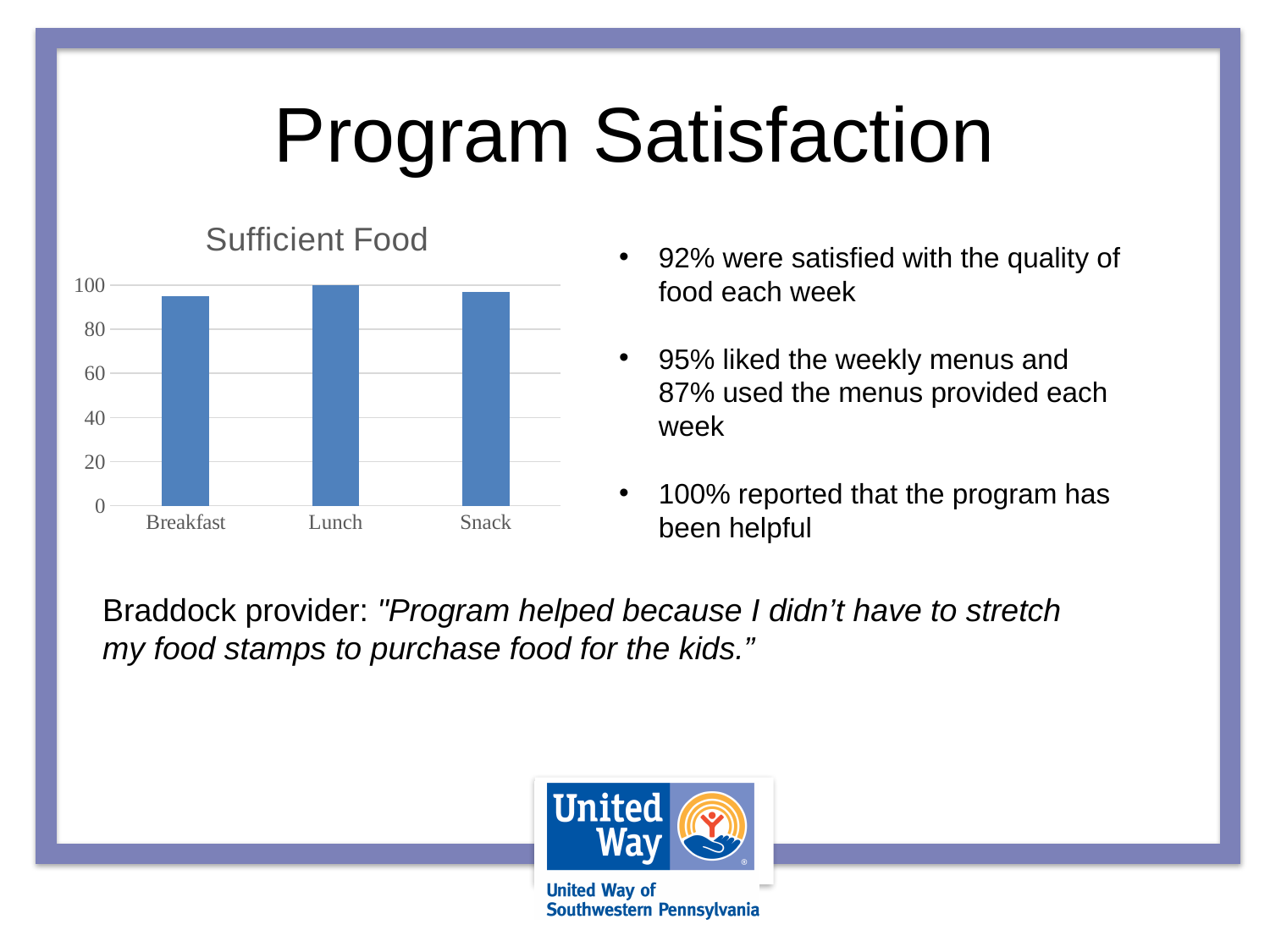
In the Sufficient Food chart, is the value for Lunch larger or smaller than the value for Breakfast? larger Is the value for Snack in the Sufficient Food chart greater or less than 80? greater What kind of chart is shown under the title "Sufficient Food"? bar chart Which category appears first on the x axis of the Sufficient Food chart? Breakfast What is the highest value shown on the y axis of the Sufficient Food chart? 100 What is the value for Lunch in the Sufficient Food chart? 100 Is the value for Breakfast in the Sufficient Food chart greater or less than 100? less Is the value for Snack in the Sufficient Food chart greater or less than 60? greater What is the title of the chart on the slide? Sufficient Food Which category has the highest value in the Sufficient Food chart? Lunch How many categories are shown on the x axis of the Sufficient Food chart? 3